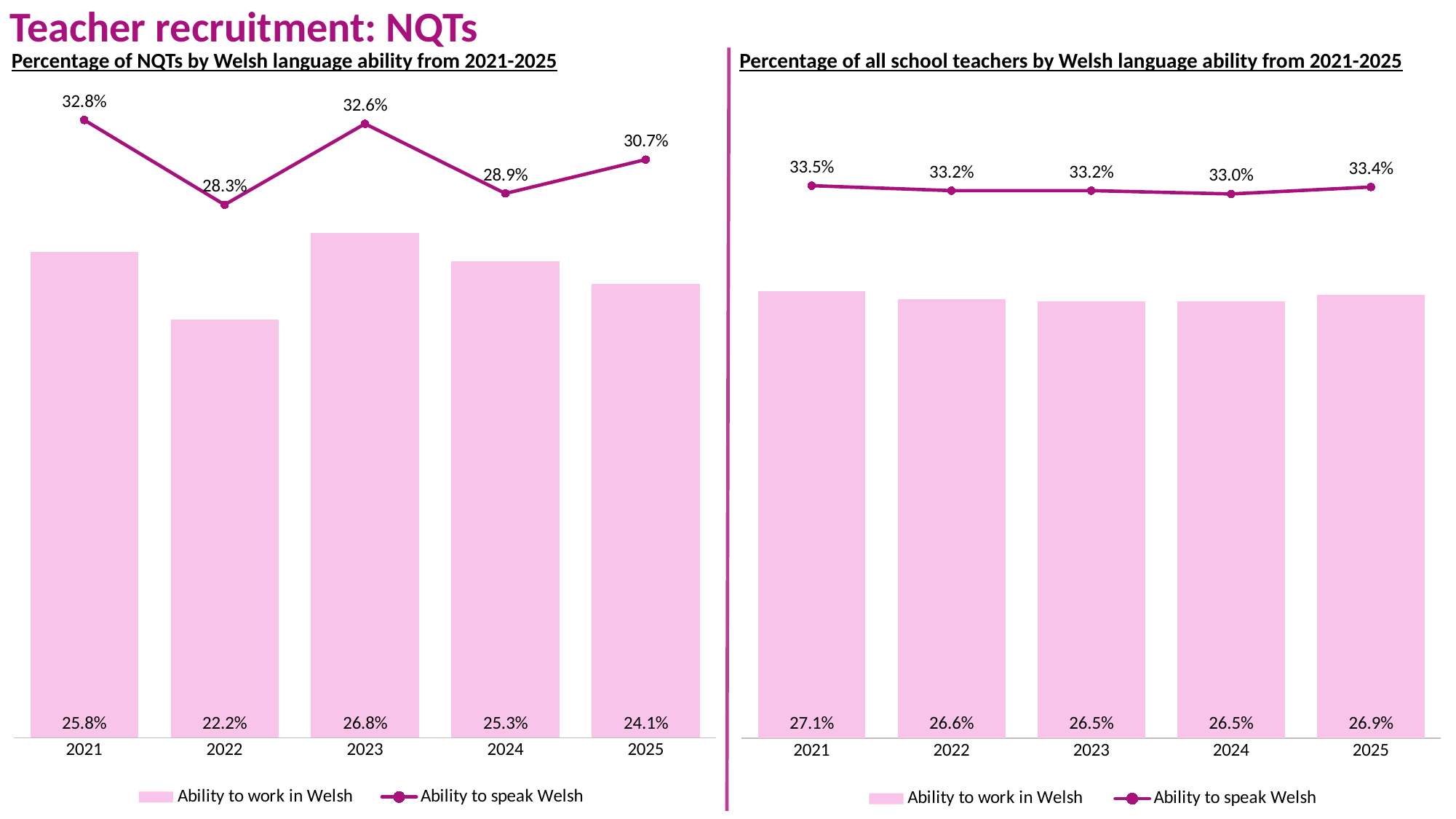
In the 'Percentage of NQTs by Welsh language ability from 2021-2025' chart, what is the difference between 'Ability to speak Welsh' in 2021 and in 2022? 4.5% In the 'Percentage of NQTs by Welsh language ability from 2021-2025' chart, what is the value for 'Ability to speak Welsh' in 2023? 32.6% In the 'Percentage of NQTs by Welsh language ability from 2021-2025' chart, what is the value for 'Ability to work in Welsh' in 2022? 22.2% In the 'Percentage of all school teachers by Welsh language ability from 2021-2025' chart, what is the difference between 'Ability to speak Welsh' and 'Ability to work in Welsh' in 2021? 6.4% In the 'Percentage of all school teachers by Welsh language ability from 2021-2025' chart, what is the value for 'Ability to work in Welsh' in 2025? 26.9% In the 'Percentage of NQTs by Welsh language ability from 2021-2025' chart, which year has the highest value for 'Ability to work in Welsh'? 2023 In the 'Percentage of all school teachers by Welsh language ability from 2021-2025' chart, what is the value for 'Ability to speak Welsh' in 2024? 33.0% In the 'Percentage of NQTs by Welsh language ability from 2021-2025' chart, which year has the lowest value for 'Ability to speak Welsh'? 2022 How many series does the legend of the 'Percentage of NQTs by Welsh language ability from 2021-2025' chart list? 2 In the 'Percentage of NQTs by Welsh language ability from 2021-2025' chart, is 'Ability to work in Welsh' higher in 2024 or in 2025? 2024 In the 'Percentage of all school teachers by Welsh language ability from 2021-2025' chart, which year has the highest value for 'Ability to speak Welsh'? 2021 How many years are shown on the x axis of the 'Percentage of all school teachers by Welsh language ability from 2021-2025' chart? 5